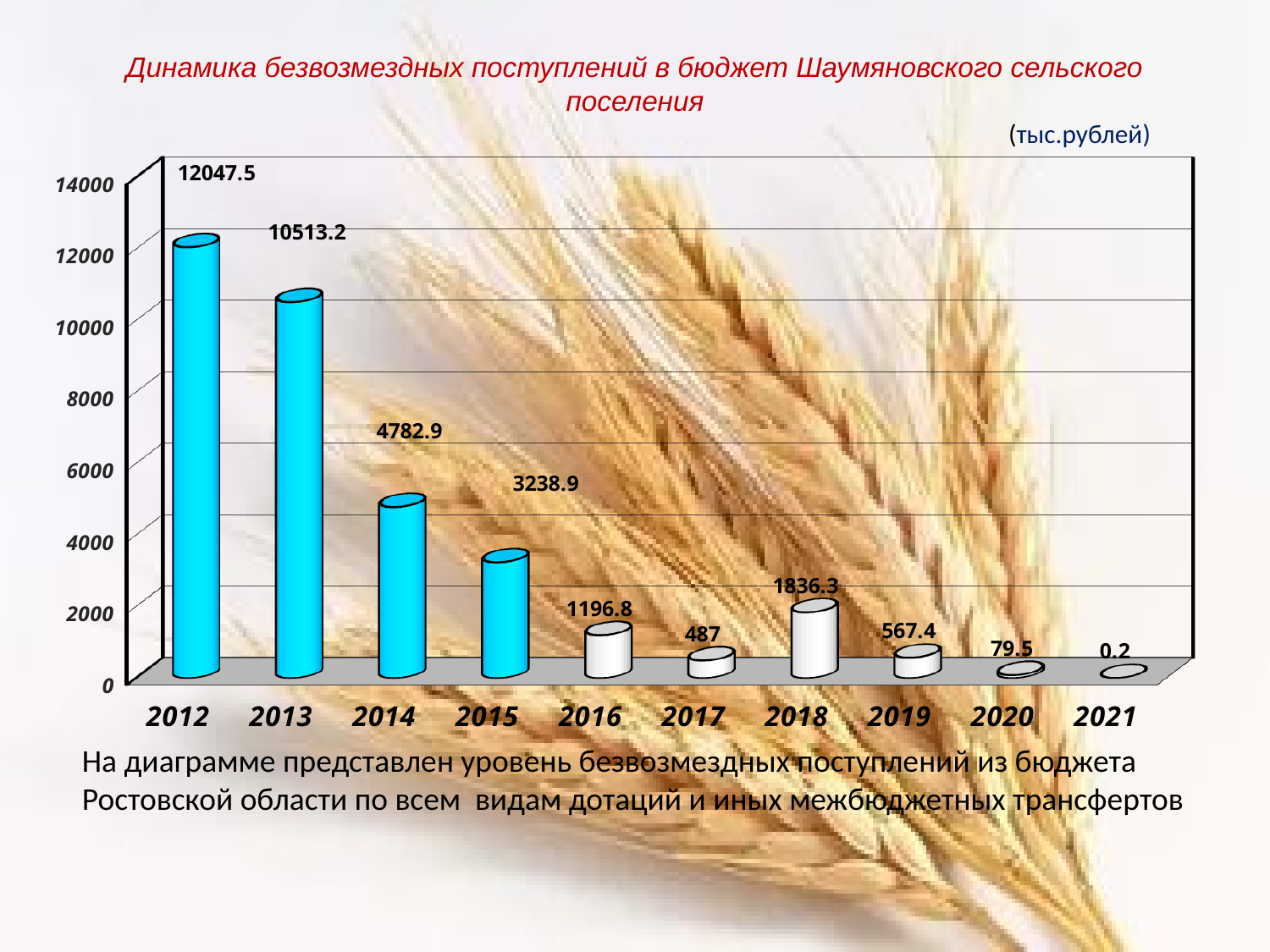
What kind of chart is this? bar chart What is the difference between the values for 2018 and 2019? 1268.9 What is the value for 2017? 487 Do the values generally rise or fall from 2012 to 2021? fall What is the value for 2021? 0.2 What is the value for 2012? 12047.5 Which year has the lowest value? 2021 How many years are shown on the x axis? 10 Is the value for 2014 greater or less than 4000? greater Which is larger, the value for 2016 or the value for 2018? 2018 Which year has the highest value? 2012 What is the difference between the values for 2012 and 2013? 1534.3